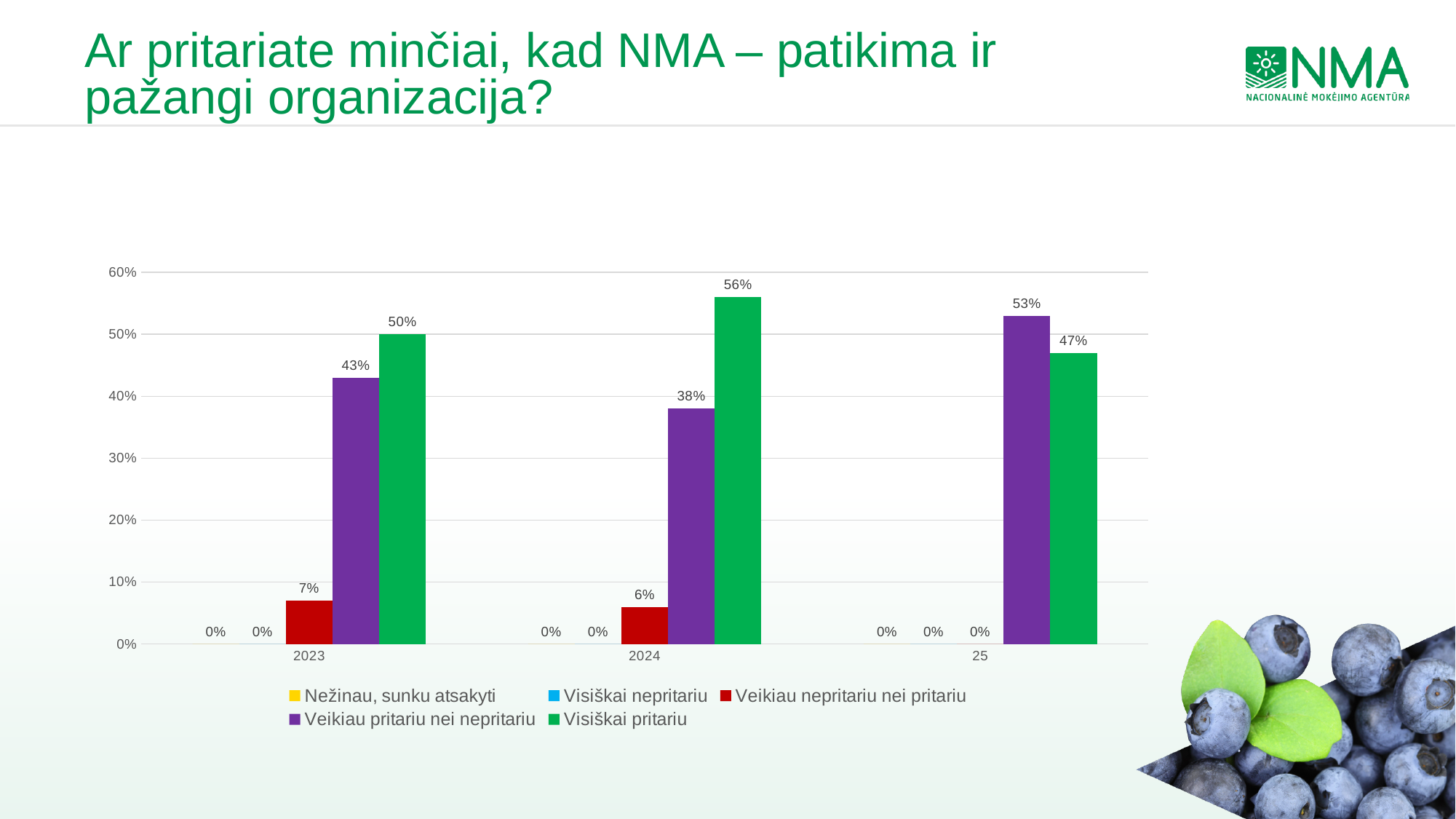
In which year is the "Visiškai pritariu" value highest? 2024 What is the value for "Veikiau nepritariu nei pritariu" in 2024? 6% What is the value for "Visiškai pritariu" in 2024? 56% What kind of chart is shown on the slide? bar chart What is the value for "Veikiau pritariu nei nepritariu" in 2023? 43% What is the difference between the "Visiškai pritariu" value in 2024 and in 2023? 6% Which colour represents "Visiškai pritariu" in the legend? green How many series does the legend list? 5 How does the "Veikiau nepritariu nei pritariu" value change from 2023 to the category labelled 25? falls How many year categories are shown on the x axis? 3 In which year is the "Veikiau pritariu nei nepritariu" value lowest? 2024 In the category labelled 25, which is larger: "Veikiau pritariu nei nepritariu" or "Visiškai pritariu"? Veikiau pritariu nei nepritariu